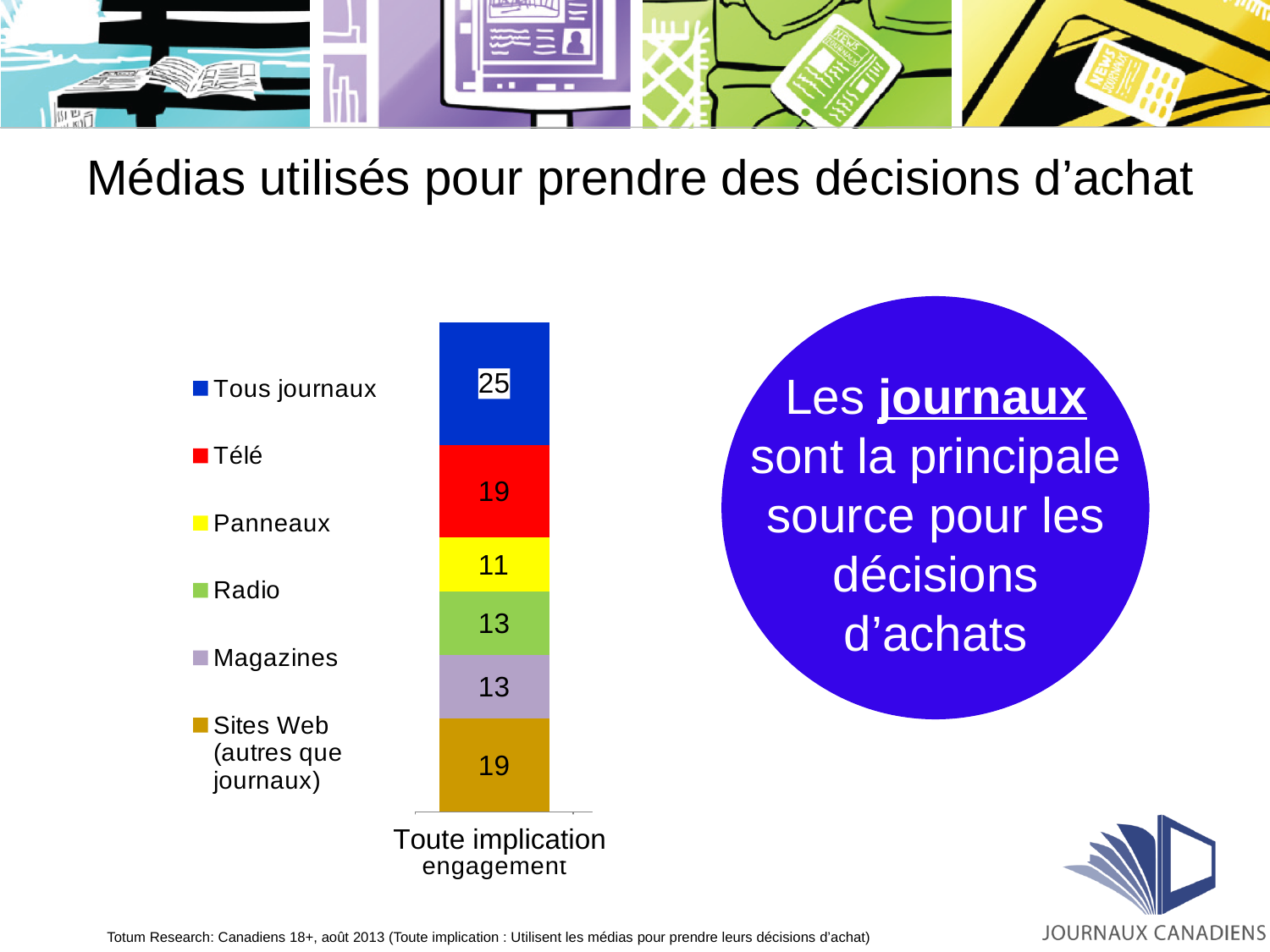
Which is larger, the value for Radio or the value for Panneaux? Radio What is the difference between the values for Tous journaux and Télé? 6 What colour represents Télé in the chart? Red How many series does the legend list? 6 What value is shown for Tous journaux in the stacked bar? 25 What value is shown for Panneaux in the stacked bar? 11 What value is shown for Sites Web (autres que journaux) in the stacked bar? 19 What kind of chart is shown on the slide? Stacked bar chart What value is shown for Télé in the stacked bar? 19 Which series has the lowest value in the stacked bar? Panneaux Which series has the highest value in the stacked bar? Tous journaux What is the total of the stacked bar for Toute implication engagement? 100